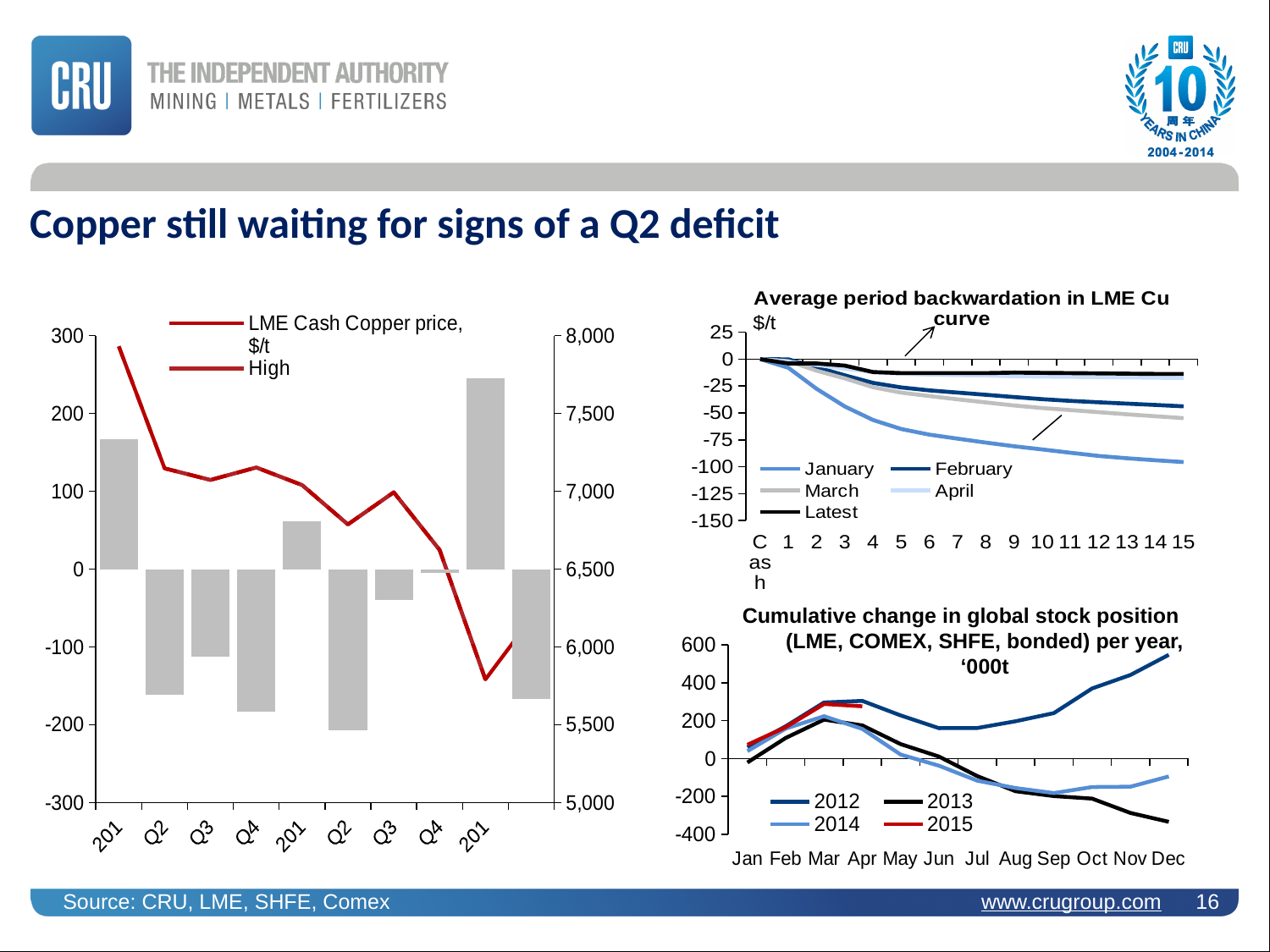
In the bottom right chart 'Cumulative change in global stock position', how many months are shown on the x axis? 12 In the bottom right chart 'Cumulative change in global stock position', how many series does the legend list? 4 In the bottom right chart 'Cumulative change in global stock position', is the value for 2012 in Dec greater or less than 400? greater In the left chart, what is the highest value shown on the right-hand axis? 8,000 What kind of chart is the top right chart titled 'Average period backwardation in LME Cu curve'? line chart In the top right chart 'Average period backwardation in LME Cu curve', which series is highest at period 15? Latest In the bottom right chart 'Cumulative change in global stock position', does the 2013 series rise or fall from Mar to Dec? fall In the bottom right chart 'Cumulative change in global stock position', which series is highest in Dec? 2012 In the top right chart 'Average period backwardation in LME Cu curve', is the value for January at period 15 greater or less than -75? less In the top right chart 'Average period backwardation in LME Cu curve', which series is lowest at period 15? January In the top right chart 'Average period backwardation in LME Cu curve', how many series does the legend list? 5 In the bottom right chart 'Cumulative change in global stock position', which series is lowest in Dec? 2013